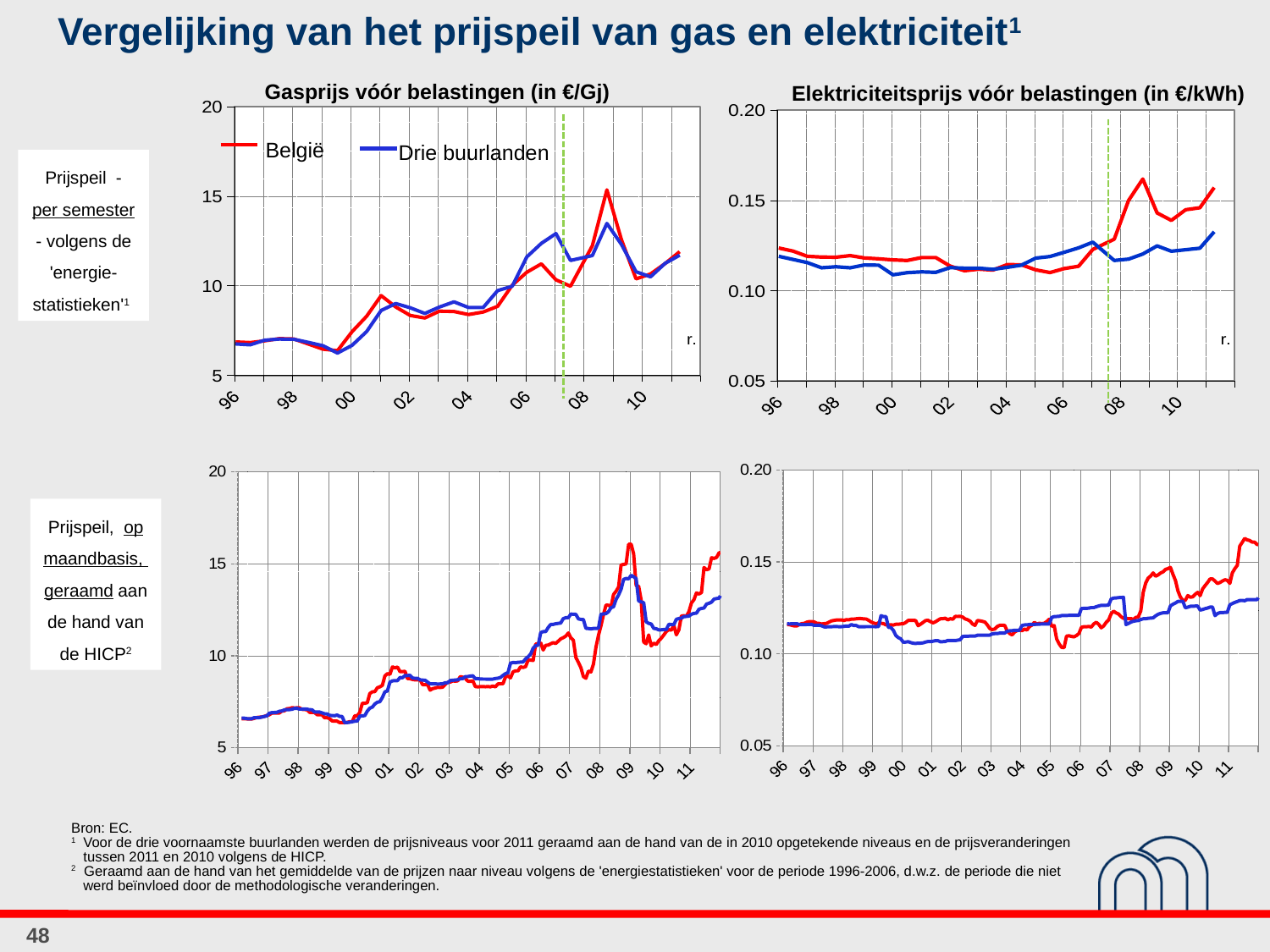
In the top-left chart 'Gasprijs vóór belastingen', is the peak value for België around 2009 greater or less than 15? greater In the top-right chart 'Elektriciteitsprijs vóór belastingen', is the value for Drie buurlanden in 2011 greater or less than 0.15? less In the top-left chart 'Gasprijs vóór belastingen', which series reaches the higher peak around 2009, België or Drie buurlanden? België In the top-left chart 'Gasprijs vóór belastingen', does the gas price for België overall rise or fall between 1996 and 2011? rise In the top-left chart 'Gasprijs vóór belastingen', what are the two series named in the legend? België and Drie buurlanden In the top-left chart 'Gasprijs vóór belastingen', is the peak value for Drie buurlanden around 2009 greater or less than 15? less In the top-left chart 'Gasprijs vóór belastingen', how many series does the legend list? 2 In what unit is the electricity price expressed in the top-right chart? €/kWh What kind of chart is the top-left chart titled 'Gasprijs vóór belastingen (in €/Gj)'? Line chart